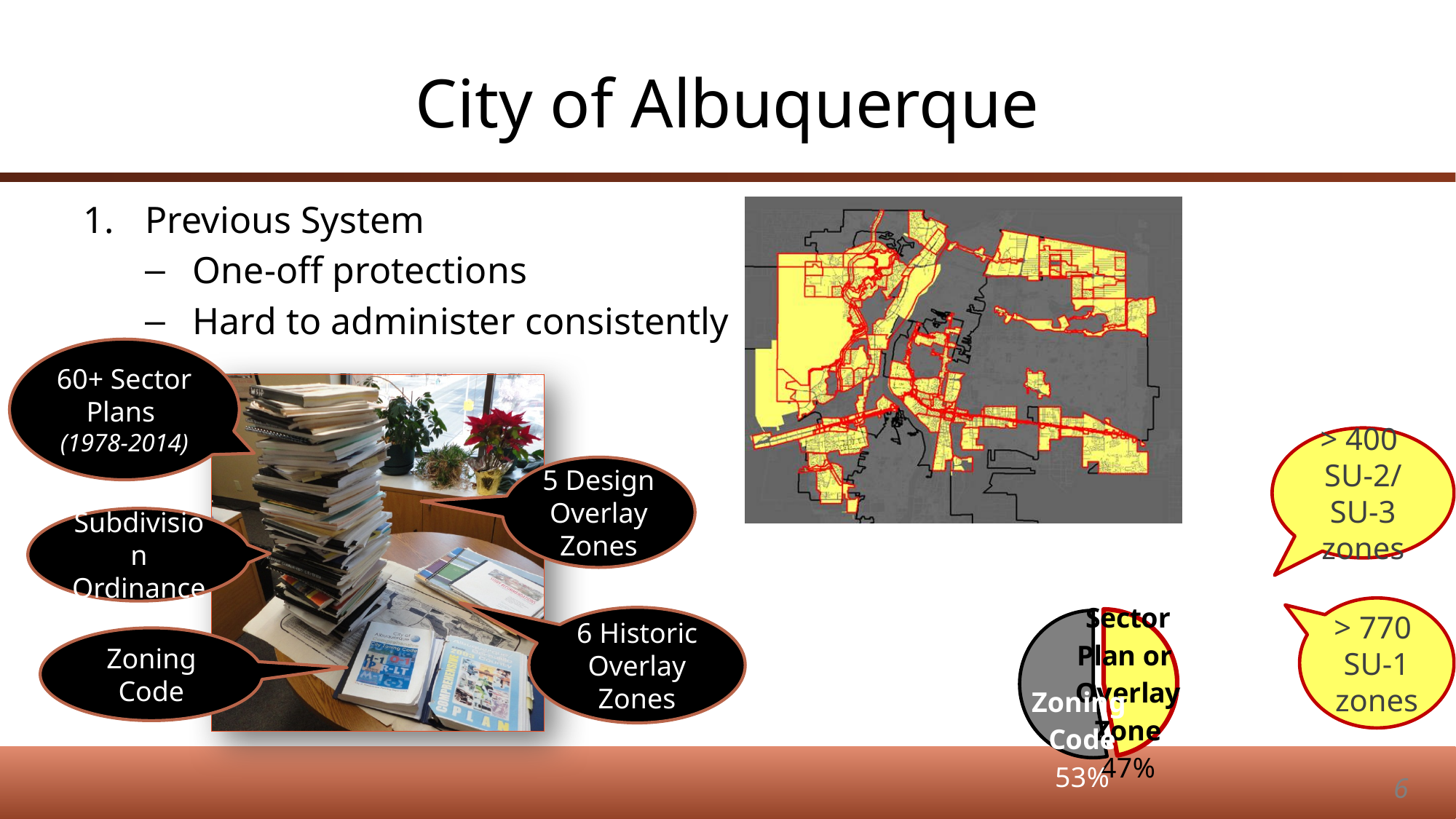
In the pie chart, which is larger: Zoning Code or Sector Plan or Overlay Zone? Zoning Code What colour is the Zoning Code slice in the pie chart? grey In the pie chart, what percentage is labelled for Sector Plan or Overlay Zone? 47% In the pie chart, what is the difference in percentage points between Zoning Code and Sector Plan or Overlay Zone? 6 percentage points Which slice of the pie chart is the smallest? Sector Plan or Overlay Zone Which slice of the pie chart is the largest? Zoning Code Is the Zoning Code share in the pie chart greater or less than 50%? greater How many slices does the pie chart have? 2 What kind of chart is shown at the bottom right of the slide? pie chart In the pie chart, what percentage is labelled for Zoning Code? 53% What colour is the Sector Plan or Overlay Zone slice in the pie chart? yellow